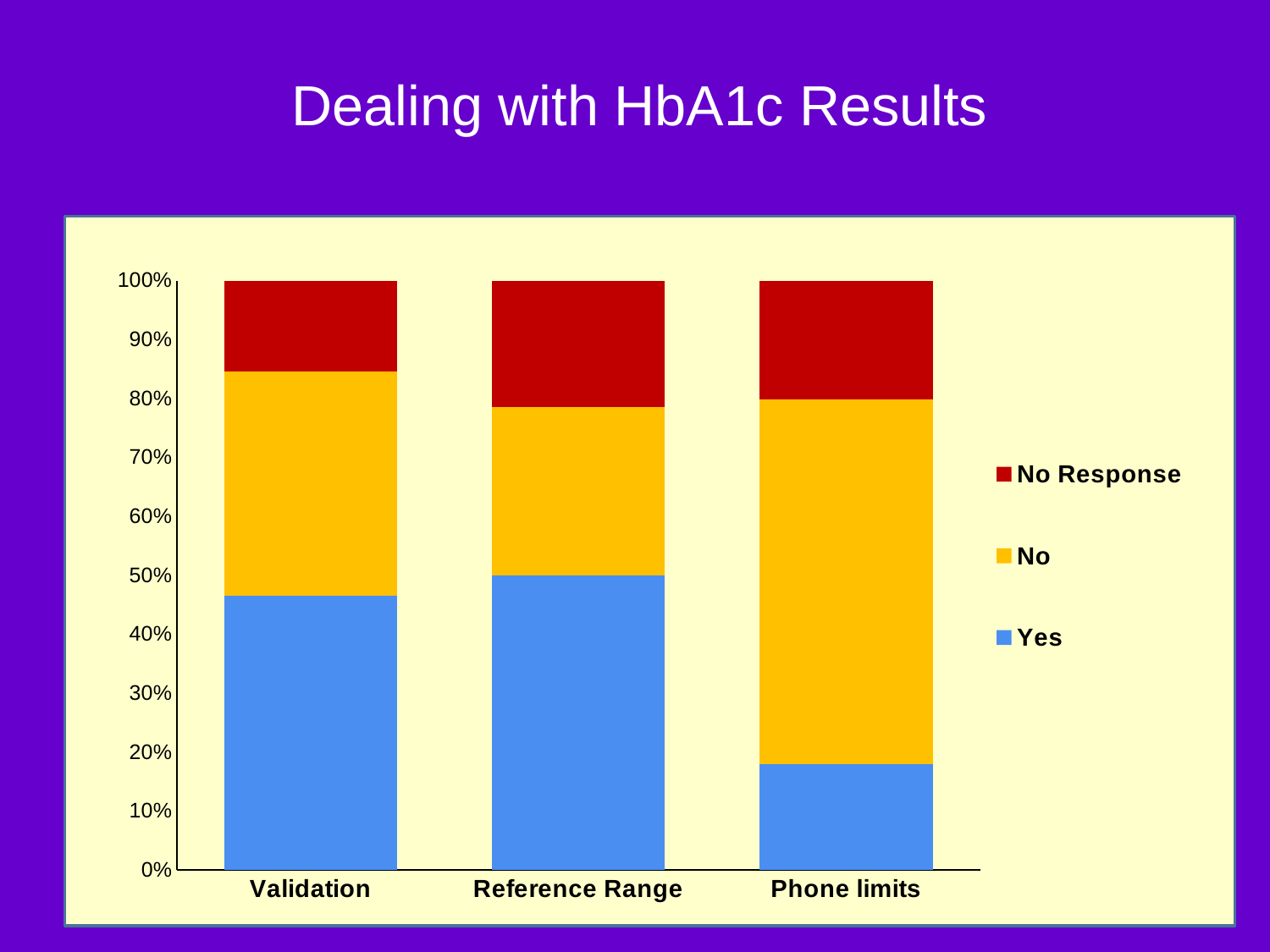
What is the total of the stacked bar for Validation? 100% Is the Yes value for Phone limits greater or less than 20%? less How many categories are shown on the x axis? 3 What is the title of the slide containing the chart? Dealing with HbA1c Results Which category has the lowest Yes share? Phone limits Which is larger, the Yes share for Reference Range or the Yes share for Phone limits? Reference Range How many series does the legend list? 3 Which category has the highest No share? Phone limits What kind of chart is shown on the slide? Stacked bar chart Which series is shown in blue in the legend? Yes Is the Yes value for Validation greater or less than 40%? greater Which category has the largest No Response share? Reference Range